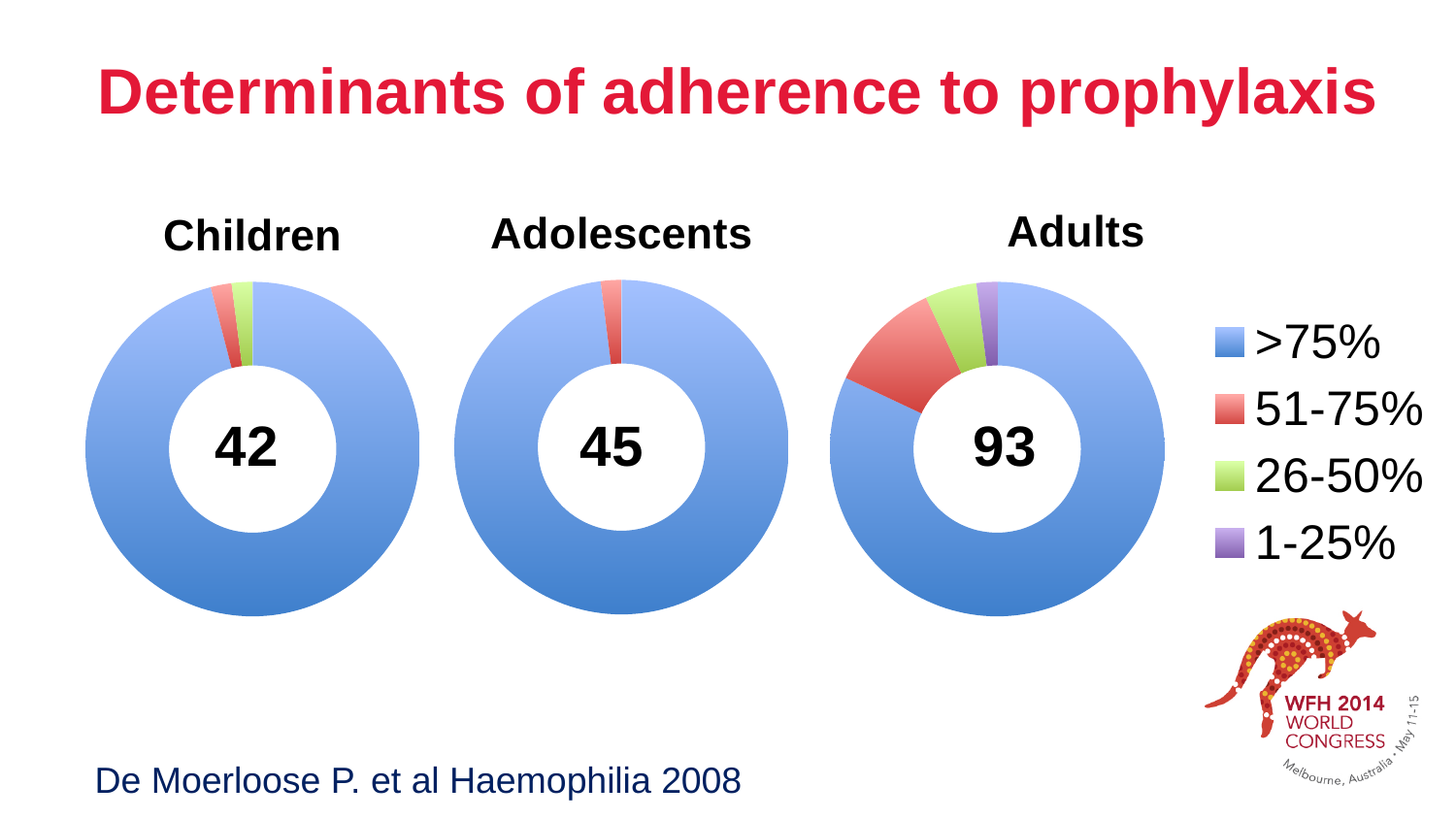
What number is printed in the centre of the Children chart? 42 What number is printed in the centre of the Adults chart? 93 What is the difference between the centre numbers of the Adults chart and the Children chart? 51 Which legend category is shown in blue? >75% What number is printed in the centre of the Adolescents chart? 45 How many donut charts are on the slide? 3 Which chart has the smallest number printed in its centre? Children Which of the three charts has the largest 51-75% slice? Adults What kind of charts are shown on the slide? Donut (pie) charts In the Adults chart, which legend category takes up the largest share of the ring? >75% Which chart has the largest number printed in its centre? Adults How many categories does the legend list? 4